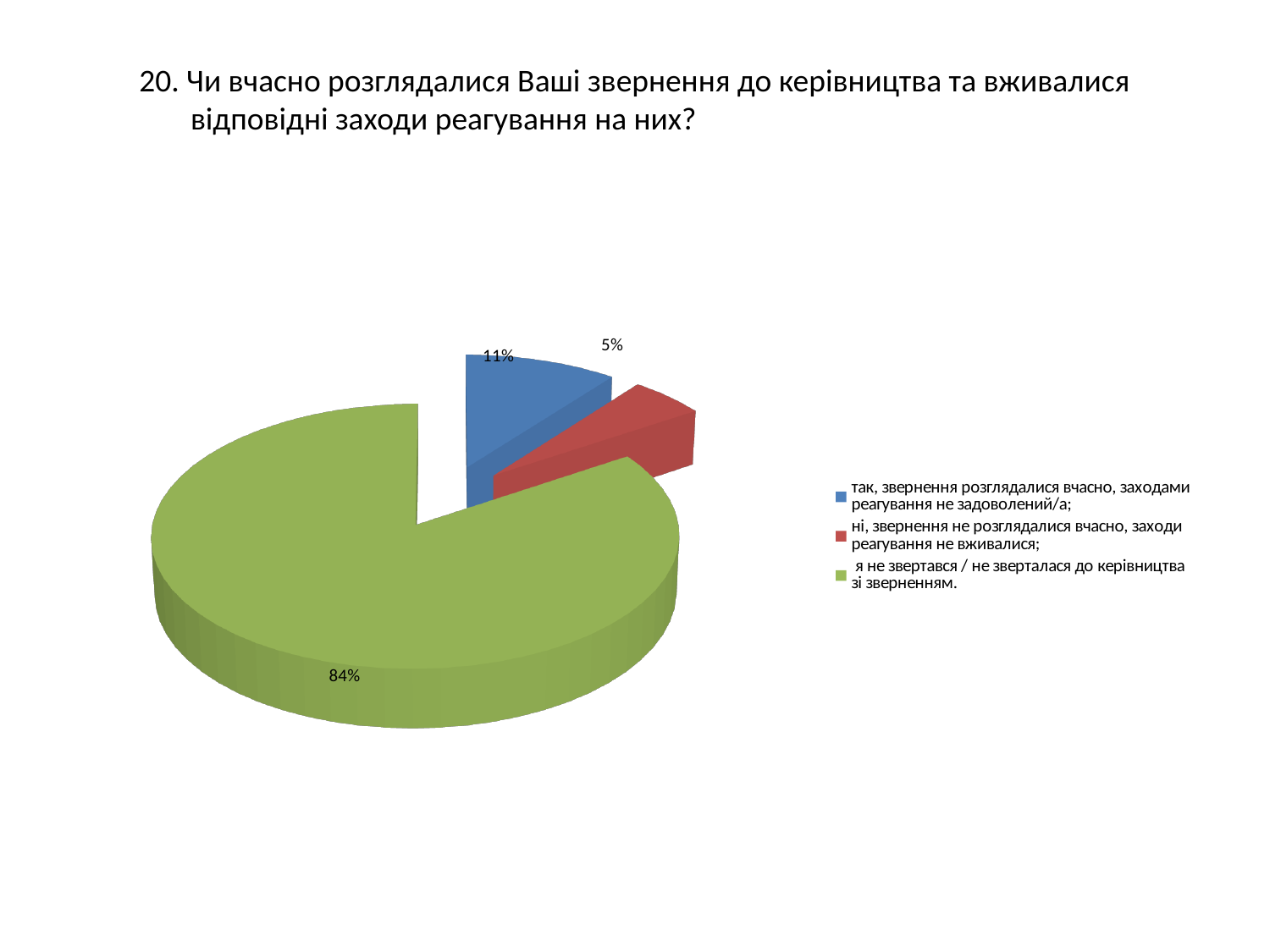
What kind of chart is shown on the slide? pie chart What is the difference in percentage points between the largest slice (84%) and the slice labelled 11%? 73 How many entries does the legend list? 3 How many slices does the pie chart have? 3 Which is larger: the slice for "так, звернення розглядалися вчасно, заходами реагування не задоволений/а" or the slice for "ні, звернення не розглядалися вчасно, заходи реагування не вживалися"? так, звернення розглядалися вчасно, заходами реагування не задоволений/а What colour is the slice representing 84%? green Which category has the largest slice of the pie? я не звертався / не зверталася до керівництва зі зверненням What share of the pie is the slice for "ні, звернення не розглядалися вчасно, заходи реагування не вживалися"? 5% What share of the pie is the slice for "я не звертався / не зверталася до керівництва зі зверненням"? 84% What colour is the slice representing 5%? red What share of the pie is the slice for "так, звернення розглядалися вчасно, заходами реагування не задоволений/а"? 11% Which category has the smallest slice of the pie? ні, звернення не розглядалися вчасно, заходи реагування не вживалися